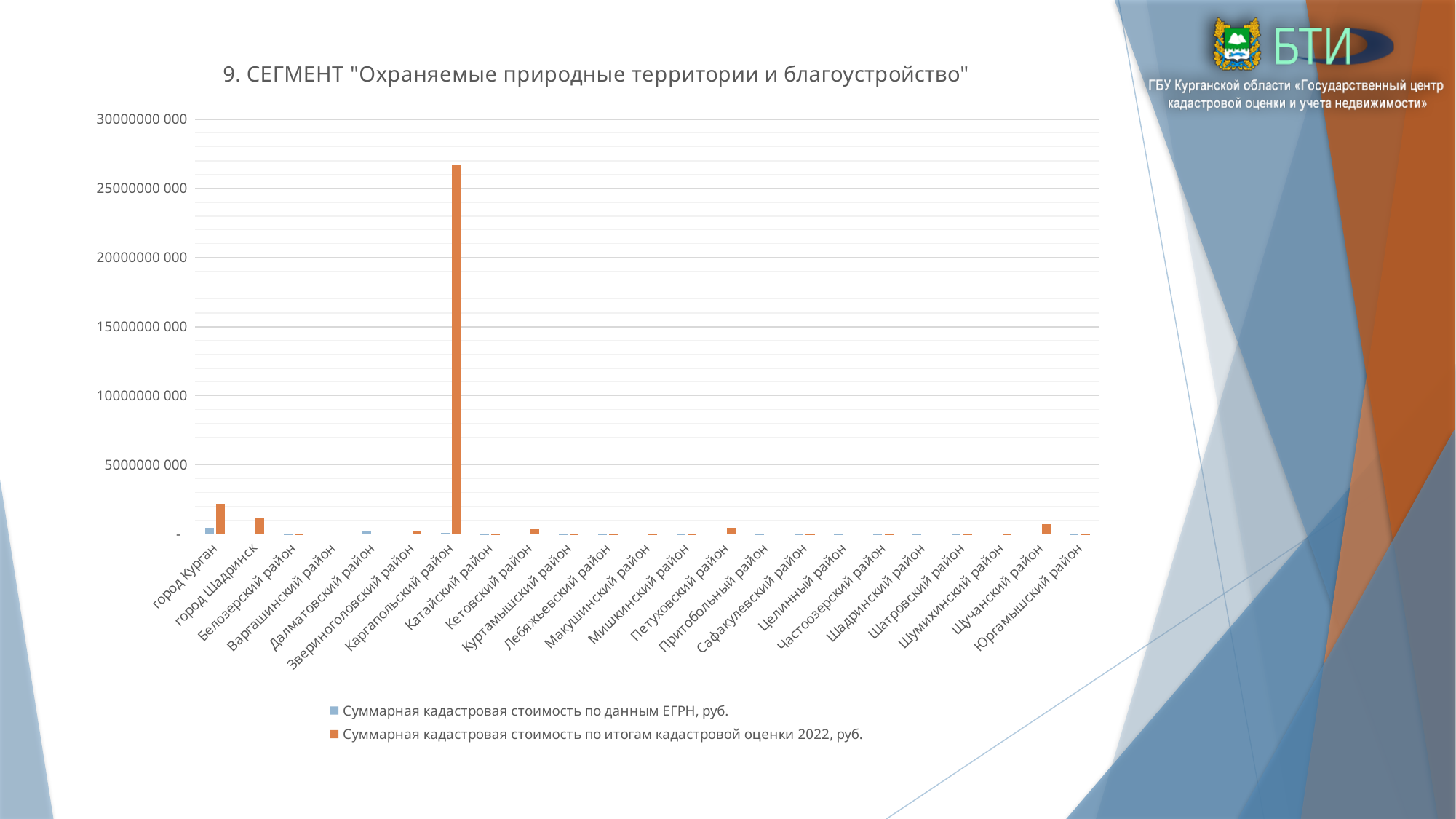
What kind of chart is shown on the slide? bar chart What is the title of the chart? 9. СЕГМЕНТ "Охраняемые природные территории и благоустройство" Which colour represents the series "Суммарная кадастровая стоимость по данным ЕГРН, руб."? blue Is the value for Каргапольский район in the series "Суммарная кадастровая стоимость по итогам кадастровой оценки 2022, руб." greater or less than 25000000 000? greater Is the value for Каргапольский район in the series "Суммарная кадастровая стоимость по итогам кадастровой оценки 2022, руб." greater or less than 30000000 000? less Which category has the highest value for "Суммарная кадастровая стоимость по итогам кадастровой оценки 2022, руб."? Каргапольский район For город Курган, which series has the larger value: "Суммарная кадастровая стоимость по данным ЕГРН, руб." or "Суммарная кадастровая стоимость по итогам кадастровой оценки 2022, руб."? Суммарная кадастровая стоимость по итогам кадастровой оценки 2022, руб. Is the value for город Курган in the series "Суммарная кадастровая стоимость по итогам кадастровой оценки 2022, руб." greater or less than 5000000 000? less Which is larger for the series "Суммарная кадастровая стоимость по итогам кадастровой оценки 2022, руб.": город Курган or город Шадринск? город Курган Which is larger for the series "Суммарная кадастровая стоимость по итогам кадастровой оценки 2022, руб.": Каргапольский район or город Курган? Каргапольский район How many series does the legend list? 2 How many categories are shown along the x axis? 23